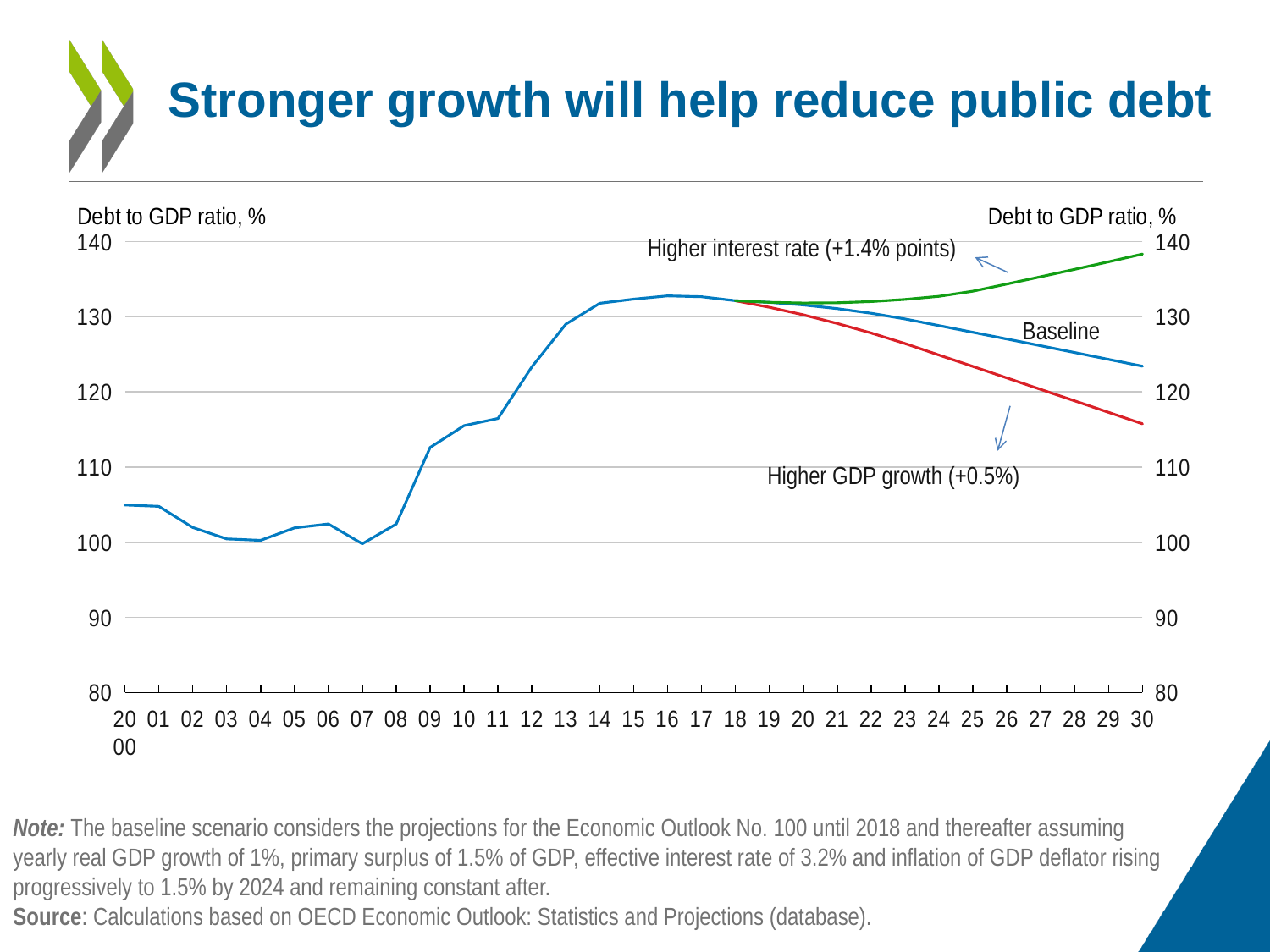
What kind of chart is shown on the slide? line chart What is the label of the vertical axis? Debt to GDP ratio, % Is the Baseline value in 2030 greater or less than 120? greater Does the Baseline debt to GDP ratio rise or fall between 2018 and 2030? fall Which scenario has the highest debt to GDP ratio in 2030? Higher interest rate (+1.4% points) Is the Higher GDP growth (+0.5%) value in 2030 greater or less than 120? less How many scenario lines are plotted on the chart? 3 Is the debt to GDP ratio in 2000 greater or less than 100? greater Which scenario line is labelled with the blue line that continues from the historical series? Baseline Which scenario has the lowest debt to GDP ratio in 2030? Higher GDP growth (+0.5%)